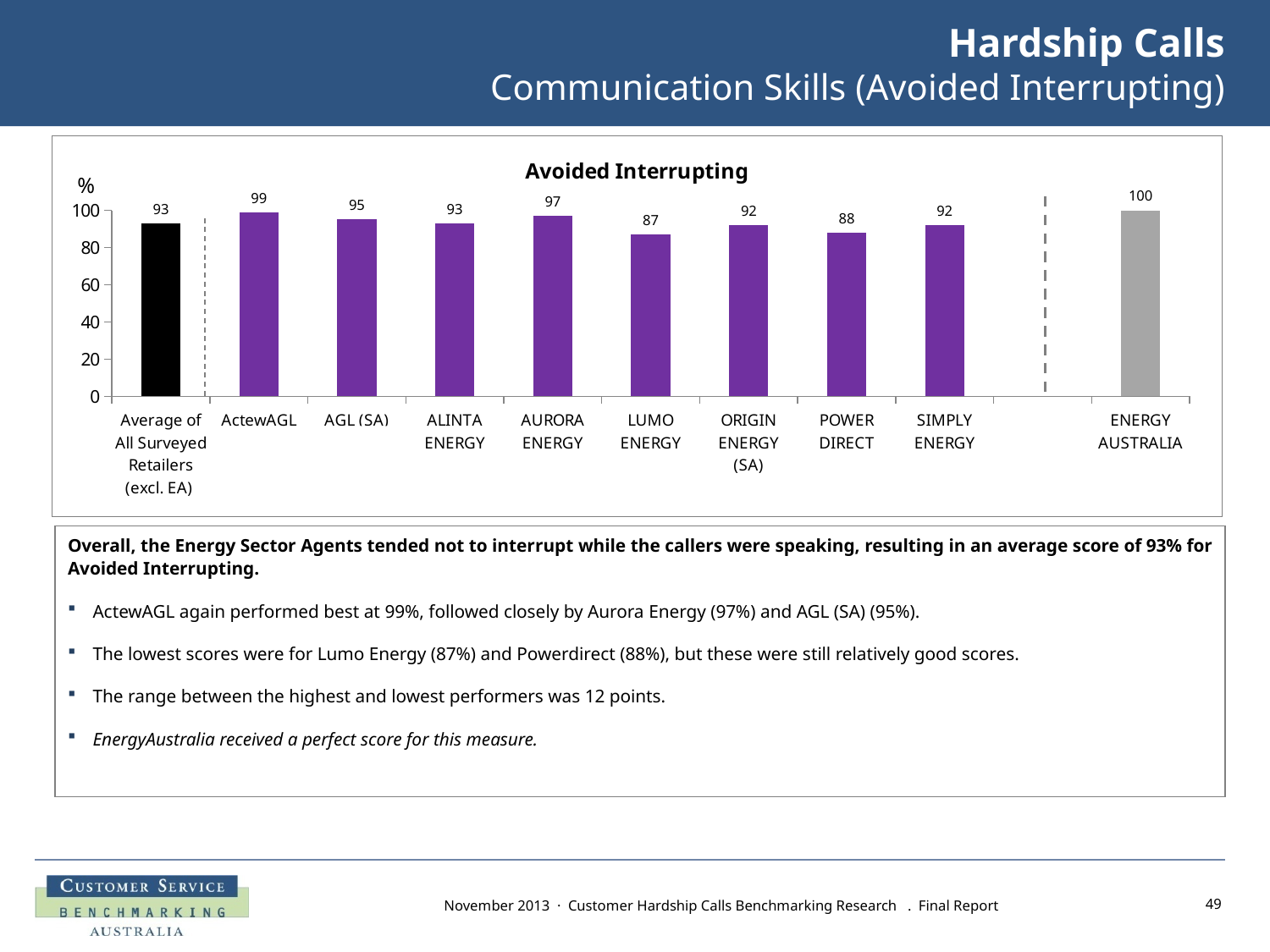
Which category has the highest value in the Avoided Interrupting chart? ENERGY AUSTRALIA What is the difference between the values for ActewAGL and LUMO ENERGY? 12 What kind of chart is shown on the slide? Bar chart Is the value for AURORA ENERGY greater or less than 80? greater Which is larger, the value for AGL (SA) or the value for POWER DIRECT? AGL (SA) How many bars are plotted in the Avoided Interrupting chart? 10 What is the value for the Average of All Surveyed Retailers (excl. EA)? 93 What is the value for LUMO ENERGY in the Avoided Interrupting chart? 87 What is the title of the chart on the slide? Avoided Interrupting What is the value for ENERGY AUSTRALIA in the chart? 100 What is the value for ActewAGL in the Avoided Interrupting chart? 99 Which category has the lowest value in the Avoided Interrupting chart? LUMO ENERGY